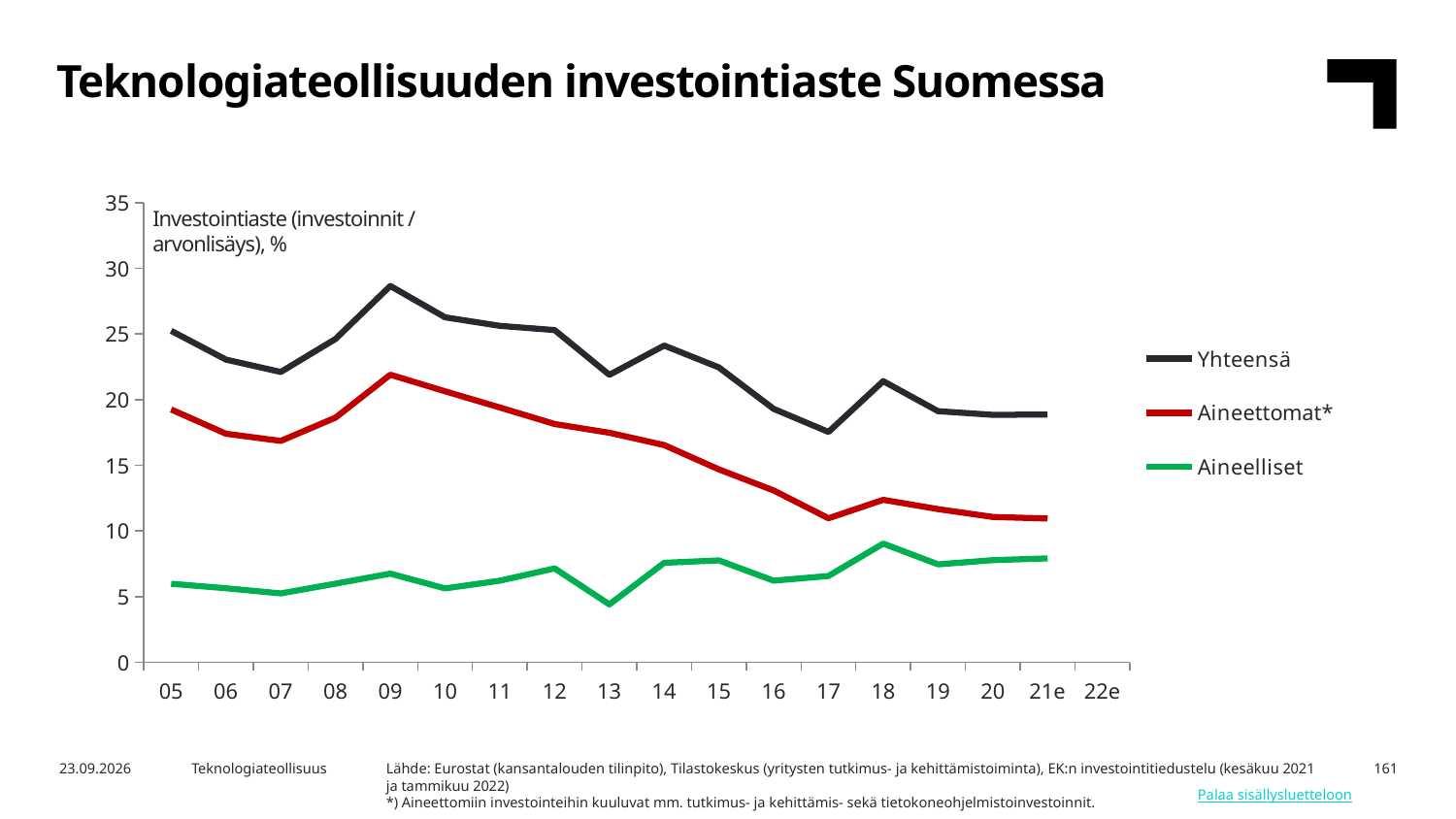
In which year does the Yhteensä series reach its highest value? 09 What kind of chart is shown on the slide? line chart Which series are listed in the legend? Yhteensä, Aineettomat*, Aineelliset Is the value for Aineettomat* in 17 greater or less than 15? less In which year does the Aineelliset series reach its lowest value? 13 How many year labels are shown on the x axis? 18 How many series does the legend list? 3 In which year does the Aineelliset series reach its highest value? 18 Does the Aineettomat* series rise or fall from 09 to 17? fall In which year does the Yhteensä series reach its lowest value? 17 Which is larger in 09, Aineettomat* or Aineelliset? Aineettomat* Is the value for Yhteensä in 09 greater or less than 25? greater